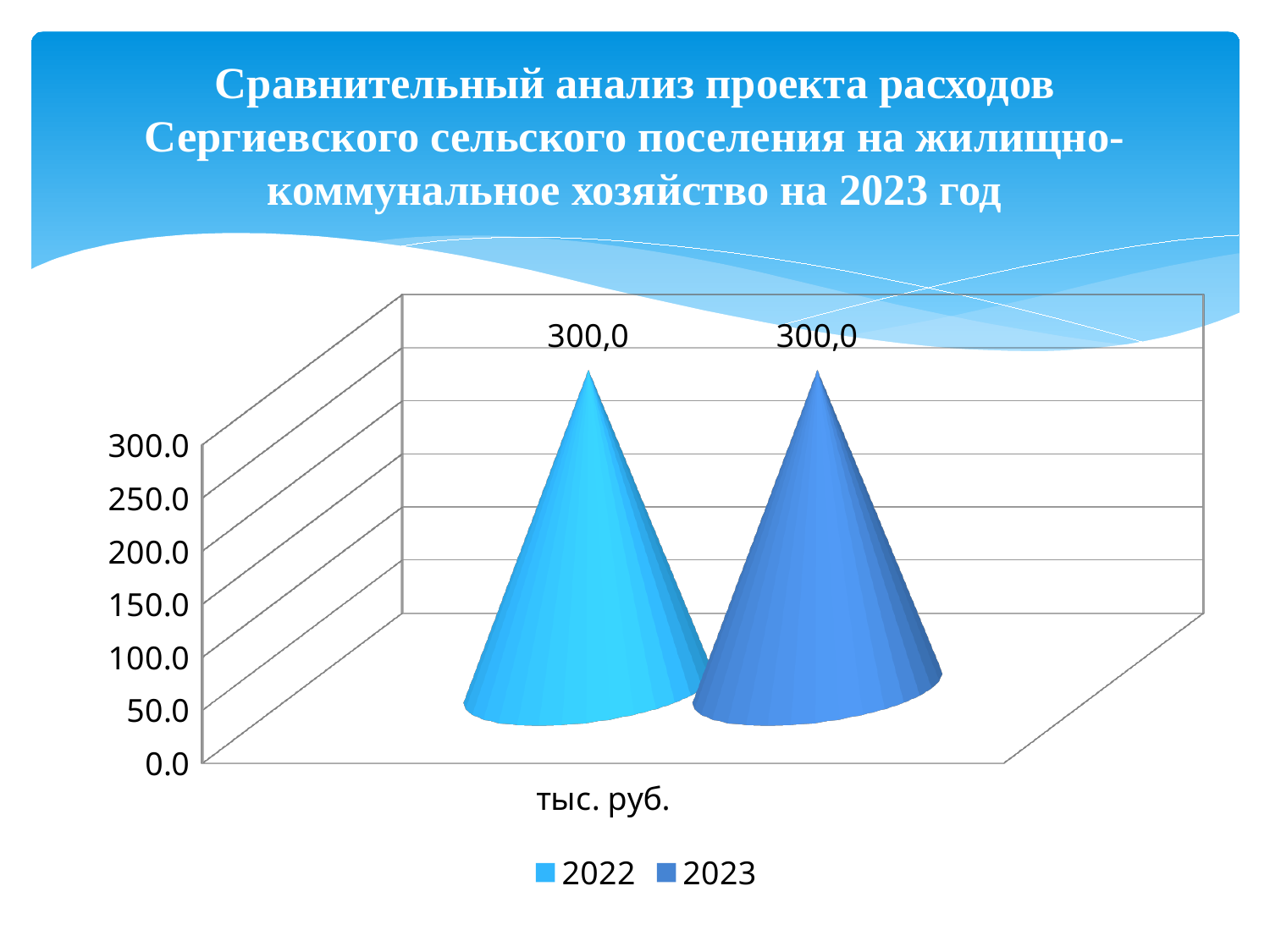
What is the difference between the 2023 value and the 2022 value? 0,0 What is the value for the 2023 series on the chart? 300,0 What kind of chart is shown on the slide? bar chart Is the value for 2023 greater or less than 200.0? greater Is the value for 2022 greater or less than 250.0? greater What is the category label shown on the x axis? тыс. руб. How many series does the legend list? 2 What is the highest value shown on the vertical axis? 300.0 How many categories are shown on the x axis of the chart? 1 What is the value for the 2022 series on the chart? 300,0 Which series is shown in the lighter blue colour? 2022